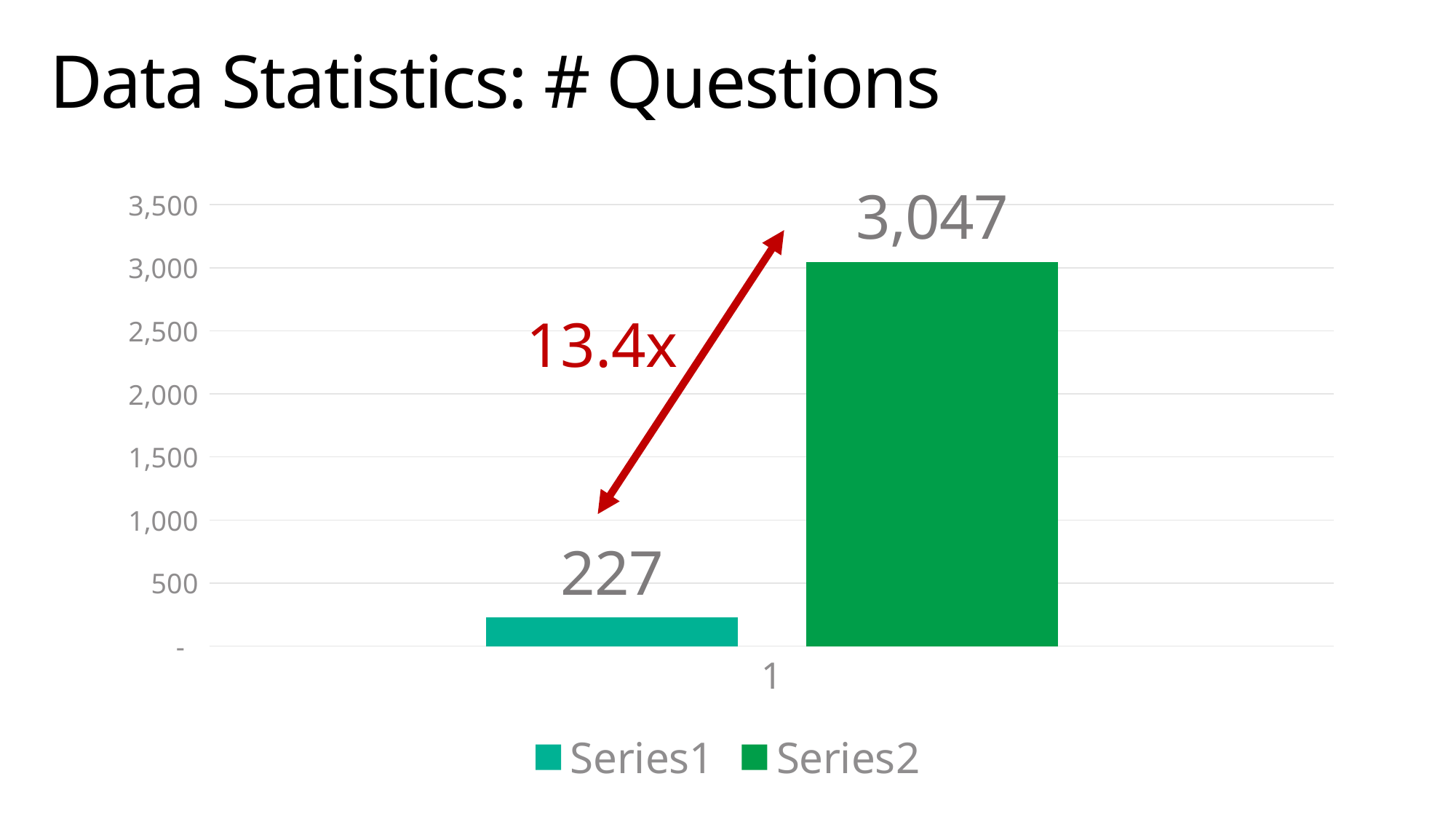
Is the value for Series2 greater or less than 3,000? greater What is the difference between the Series2 value and the Series1 value? 2,820 How many series does the legend list? 2 Is the value for Series2 larger than the value for Series1? Yes What kind of chart is shown on the slide? Bar chart What is the value for Series2? 3,047 Which series has the higher value? Series2 What is the value for Series1? 227 What is the title of the slide? Data Statistics: # Questions What multiplier is written in red between the two bars? 13.4x Is the value for Series1 greater or less than 500? less Which series has the lower value? Series1